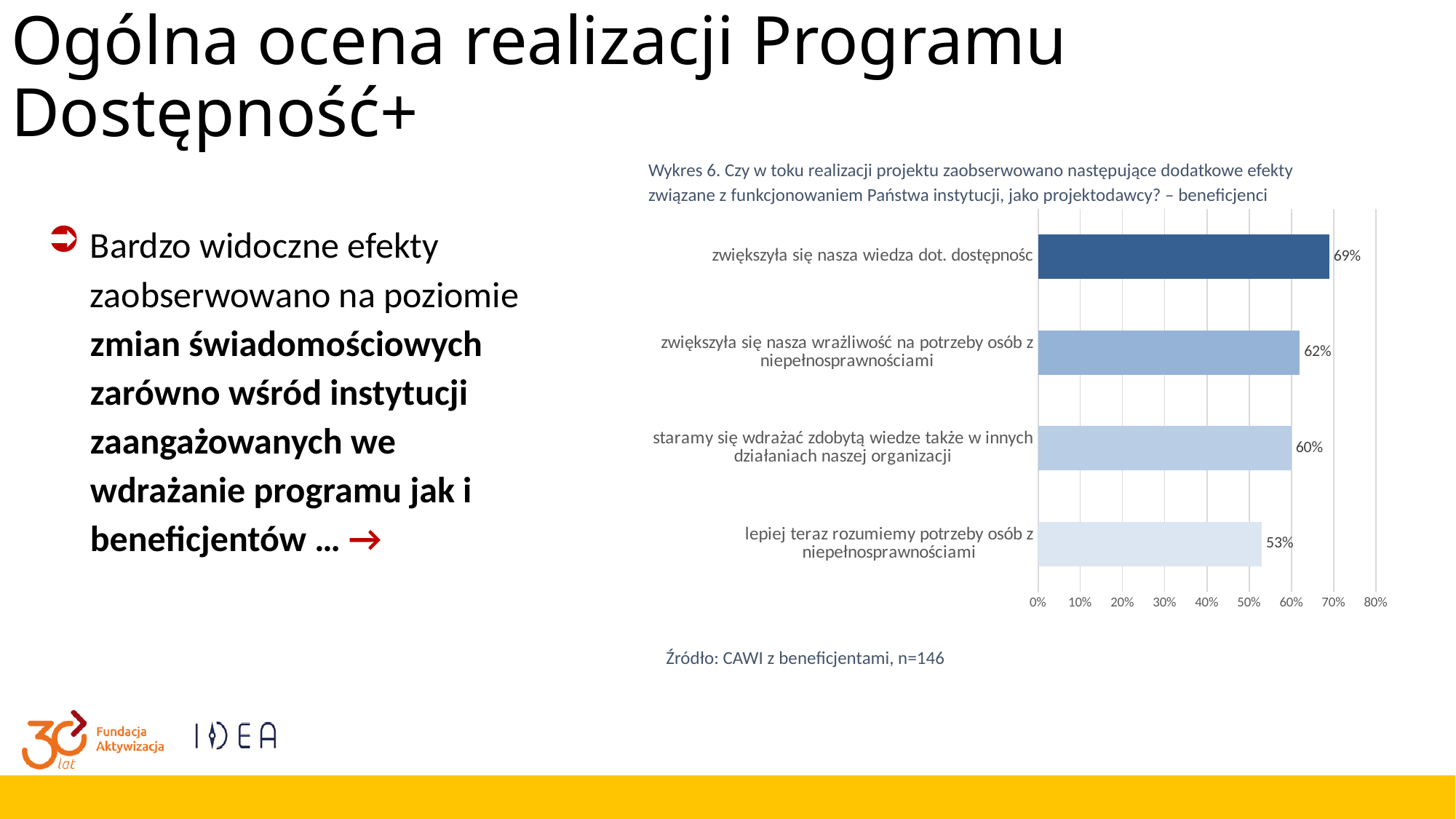
Which is larger: the value for "zwiększyła się nasza wrażliwość na potrzeby osób z niepełnosprawnościami" or for "staramy się wdrażać zdobytą wiedze także w innych działaniach naszej organizacji"? zwiększyła się nasza wrażliwość na potrzeby osób z niepełnosprawnościami What is the value for "zwiększyła się nasza wiedza dot. dostępnośc"? 69% Which category has the highest value? zwiększyła się nasza wiedza dot. dostępnośc How many categories are shown in the chart? 4 What kind of chart is shown on the slide? bar chart What is the difference between the values for "zwiększyła się nasza wiedza dot. dostępnośc" and "lepiej teraz rozumiemy potrzeby osób z niepełnosprawnościami"? 16% Is the value for "lepiej teraz rozumiemy potrzeby osób z niepełnosprawnościami" greater or less than 60%? less Which category has the lowest value? lepiej teraz rozumiemy potrzeby osób z niepełnosprawnościami What is the sample size given in the source note below the chart? n=146 What is the value for "zwiększyła się nasza wrażliwość na potrzeby osób z niepełnosprawnościami"? 62% What is the value for "lepiej teraz rozumiemy potrzeby osób z niepełnosprawnościami"? 53% What is the value for "staramy się wdrażać zdobytą wiedze także w innych działaniach naszej organizacji"? 60%